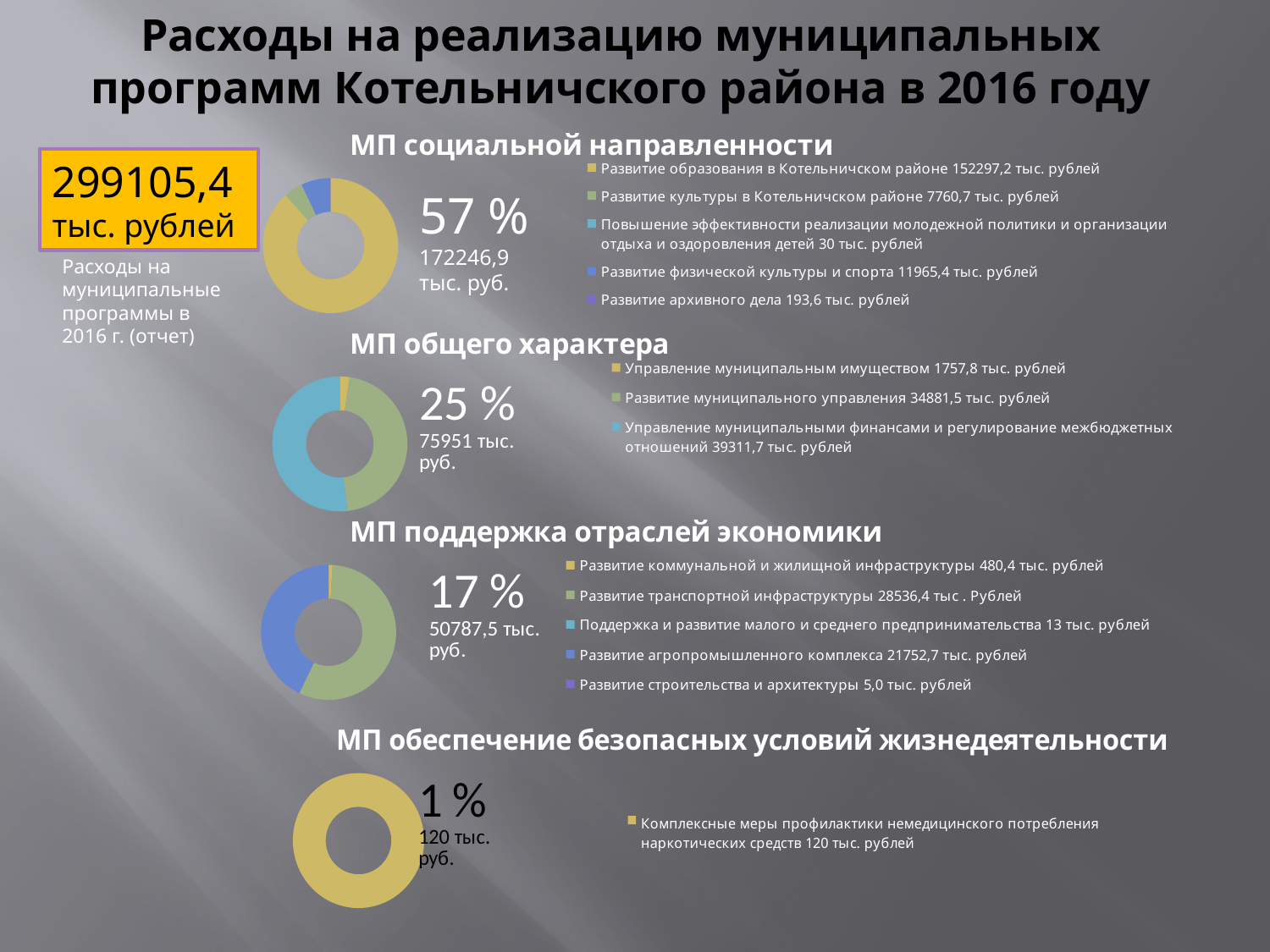
In the 'МП поддержка отраслей экономики' chart, which is larger: 'Развитие транспортной инфраструктуры' or 'Развитие агропромышленного комплекса'? Развитие транспортной инфраструктуры In the 'МП социальной направленности' chart, what is the value for 'Развитие образования в Котельничском районе'? 152297,2 тыс. рублей In the 'МП общего характера' chart, what is the difference between 'Управление муниципальными финансами и регулирование межбюджетных отношений' and 'Развитие муниципального управления'? 4430,2 тыс. рублей In the 'МП общего характера' chart, which entry has the largest value? Управление муниципальными финансами и регулирование межбюджетных отношений In the 'МП поддержка отраслей экономики' chart, what is the difference between 'Развитие транспортной инфраструктуры' and 'Развитие агропромышленного комплекса'? 6783,7 тыс. рублей What share of total expenditure does the 'МП социальной направленности' chart show? 57 % What total amount is shown next to the 'МП обеспечение безопасных условий жизнедеятельности' chart? 120 тыс. руб. In the 'МП общего характера' chart, what is the value for 'Развитие муниципального управления'? 34881,5 тыс. рублей How many donut charts are on the slide? 4 In the 'МП социальной направленности' chart, which legend entry has the smallest value? Повышение эффективности реализации молодежной политики и организации отдыха и оздоровления детей In the 'МП социальной направленности' chart, how many legend entries are listed? 5 What kind of chart is used for 'МП поддержка отраслей экономики'? Donut (pie) chart